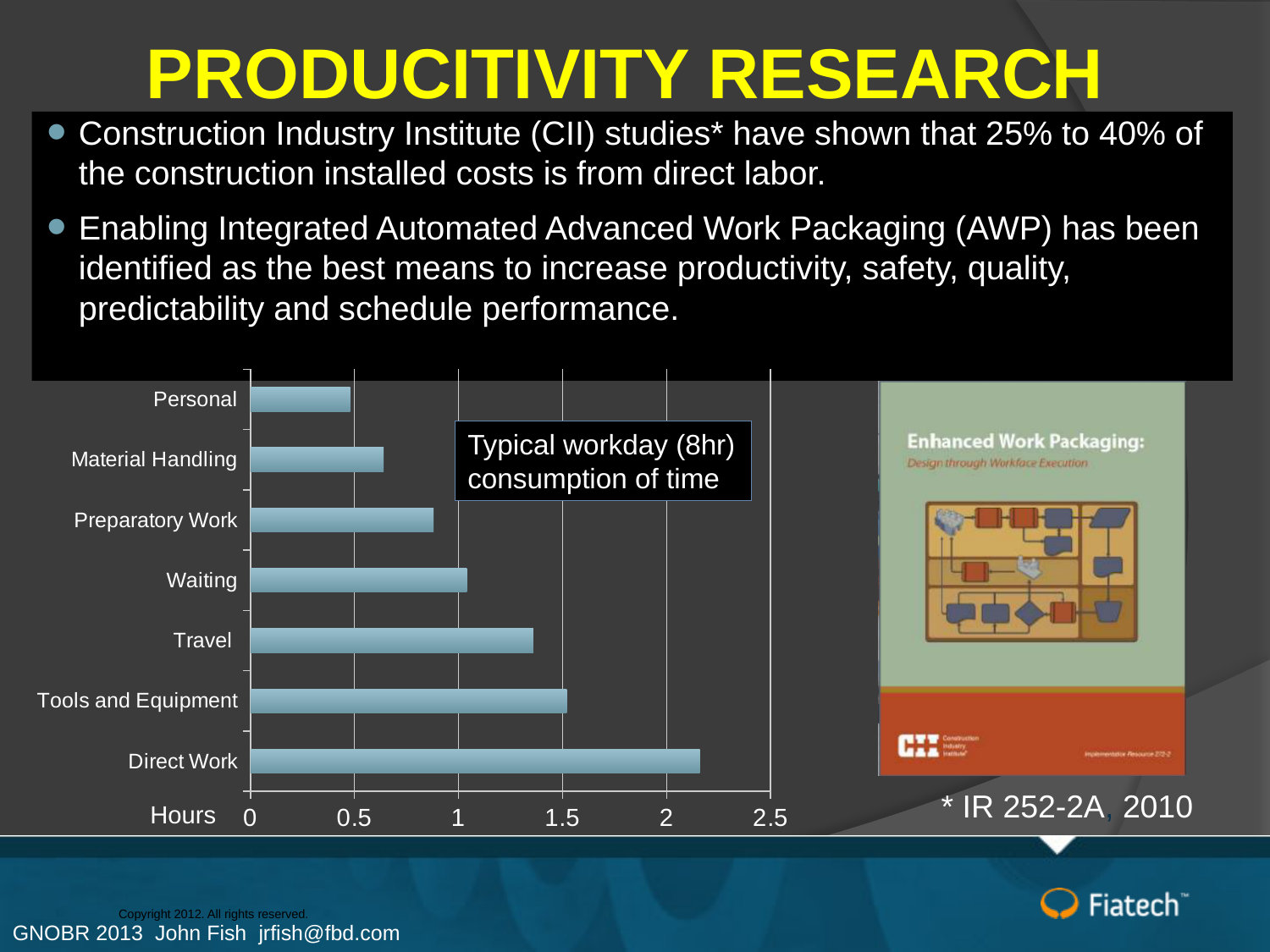
Is the value for Material Handling greater or less than 0.5? greater Which category has the highest value in the bar chart? Direct Work Which category has the lowest value in the bar chart? Personal How many categories are plotted in the bar chart? 7 Is the value for Direct Work greater or less than 2? greater Is the value for Preparatory Work greater or less than 1? less What unit is shown on the horizontal axis of the bar chart? Hours What does the text box inside the chart say the chart shows? Typical workday (8hr) consumption of time What kind of chart is shown on the slide? bar chart Which is larger, the value for Travel or the value for Waiting? Travel